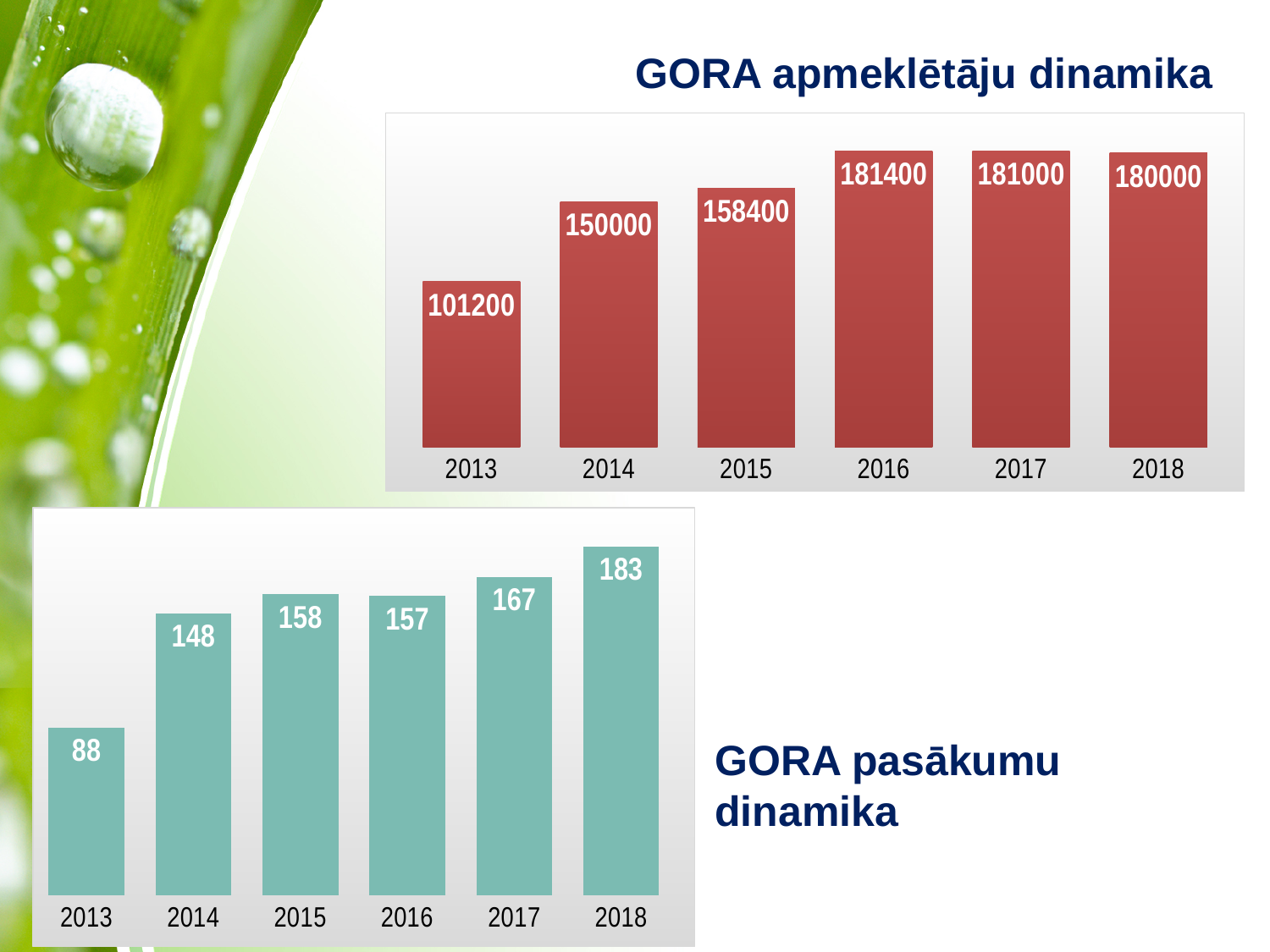
In the 'GORA apmeklētāju dinamika' chart, what is the difference between the values for 2014 and 2013? 48800 In the 'GORA apmeklētāju dinamika' chart, which year has the lowest value? 2013 In the 'GORA pasākumu dinamika' chart, which year has the lowest value? 2013 In the 'GORA pasākumu dinamika' chart, what is the difference between the values for 2018 and 2013? 95 In the 'GORA pasākumu dinamika' chart, which is larger, the value for 2015 or the value for 2016? 2015 In the 'GORA pasākumu dinamika' chart, what is the value for 2017? 167 In the 'GORA apmeklētāju dinamika' chart, how many years are shown? 6 In the 'GORA pasākumu dinamika' chart, do the values generally rise or fall from 2013 to 2018? rise In the 'GORA apmeklētāju dinamika' chart, what is the value for 2013? 101200 In the 'GORA pasākumu dinamika' chart, which year has the highest value? 2018 In the 'GORA apmeklētāju dinamika' chart, which year has the highest value? 2016 What kind of chart is the 'GORA pasākumu dinamika' chart? bar chart